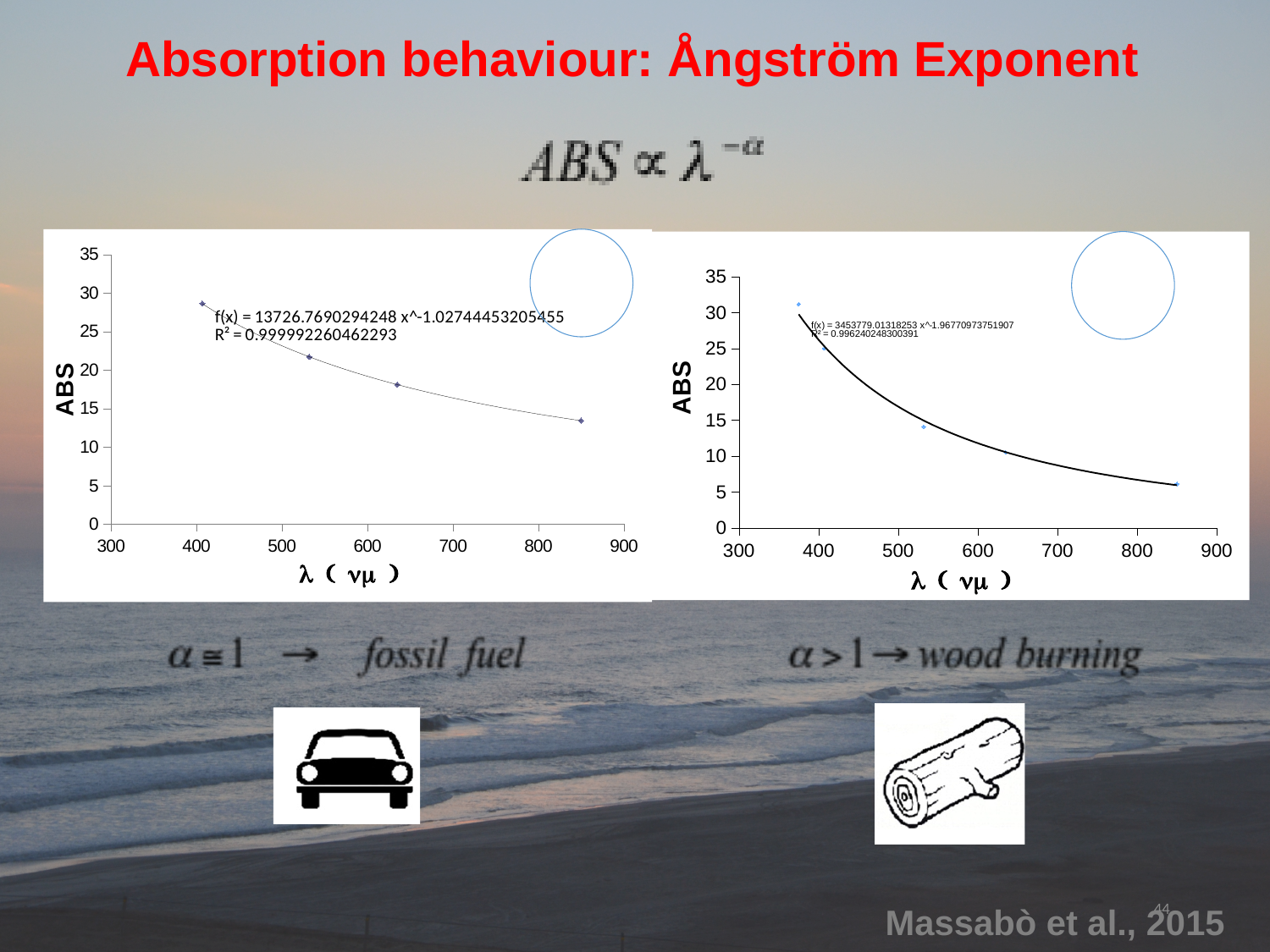
What kind of chart is the left chart? scatter chart In the right chart, do the ABS values rise or fall as wavelength increases along the x axis? fall How many data points are plotted in the left chart? 4 In the left chart, do the ABS values rise or fall as wavelength increases along the x axis? fall In the right chart, is the ABS value of the point near 850 nm greater or less than 10? less In the right chart, which point has a higher ABS value: the one near 400 nm or the one near 850 nm? the one near 400 nm What is the highest value shown on the y axis of the left chart? 35 In the left chart, is the ABS value of the point near 400 nm greater or less than 25? greater What is the R² value shown on the left chart? 0.999992260462293 In the left chart, is the ABS value of the point near 850 nm greater or less than 15? less What is the label of the y axis on the right chart? ABS